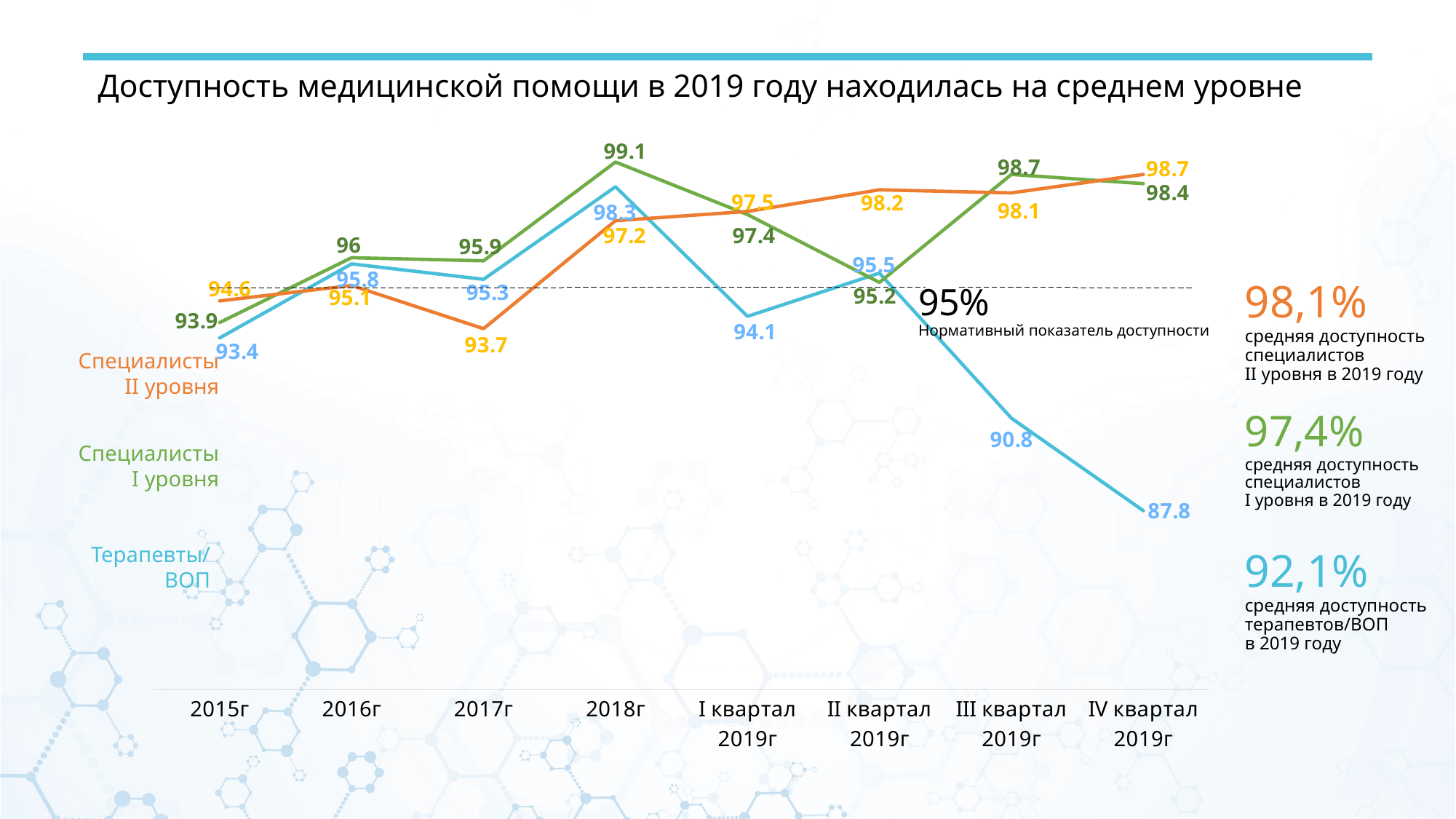
In III квартал 2019г, which series has the higher value: Специалисты I уровня or Специалисты II уровня? Специалисты I уровня How many series does the chart show? 3 How many points are plotted along the x axis of the chart? 8 What is the value for Терапевты/ВОП in IV квартал 2019г? 87.8 Does the Терапевты/ВОП series rise or fall from II квартал 2019г to IV квартал 2019г? fall What is the value for Специалисты I уровня in 2018г? 99.1 What kind of chart is shown on the slide? line chart What value does the dashed horizontal line (Нормативный показатель доступности) mark on the chart? 95% In which period does the Терапевты/ВОП series reach its lowest value? IV квартал 2019г What is the value for Специалисты II уровня in 2015г? 94.6 In which period does the Специалисты I уровня series reach its highest value? 2018г What is the difference between the Специалисты II уровня values for 2018г and 2017г? 3.5